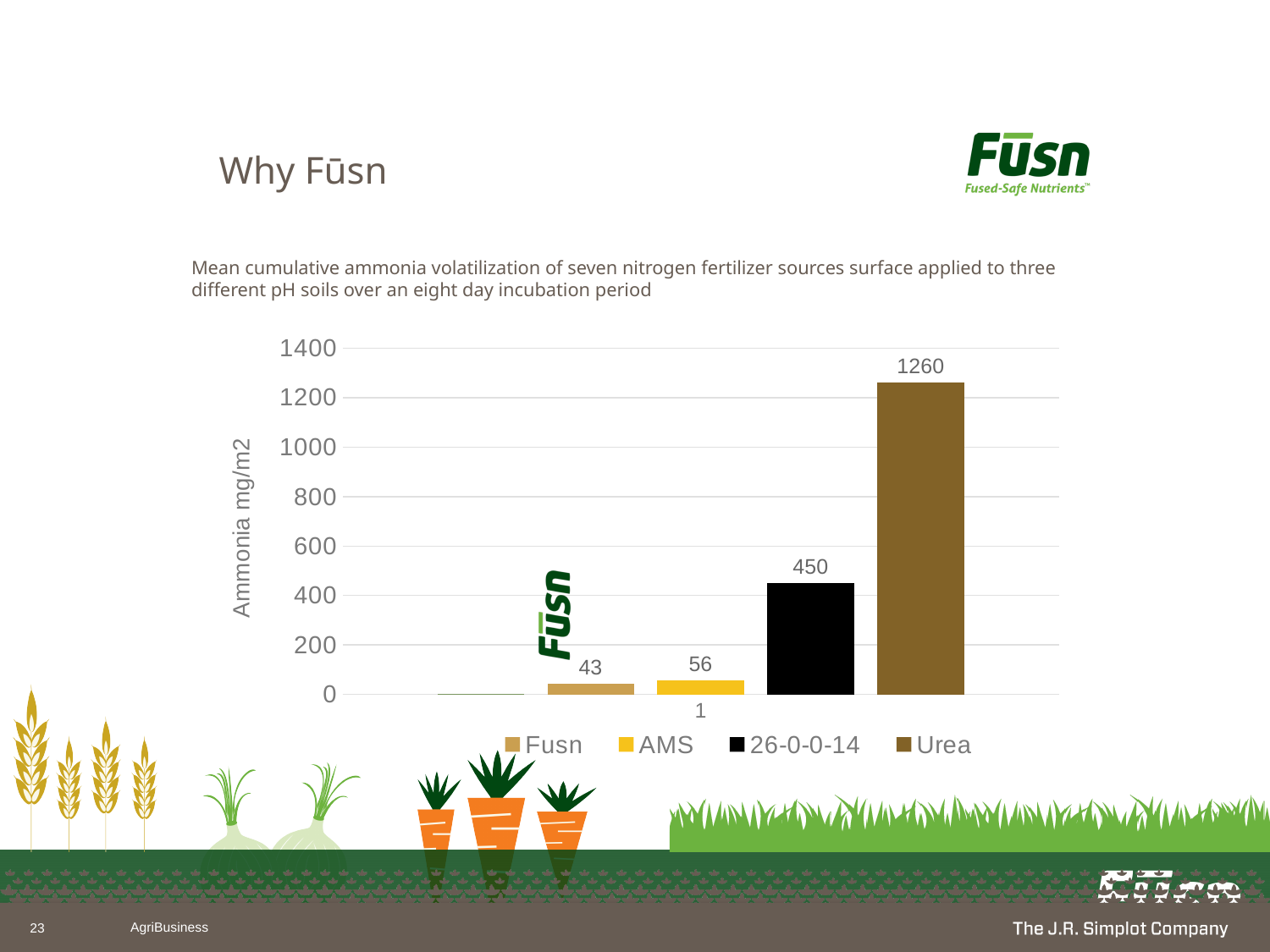
What is the y-axis title of the chart? Ammonia mg/m2 What is the difference between the Urea value and the 26-0-0-14 value? 810 What is the value for 26-0-0-14? 450 Is the value for Urea greater or less than 1200? greater What is the value for Fusn? 43 What is the value for Urea? 1260 Which labelled series has the highest value? Urea Which labelled series has the lowest value? Fusn How many series does the legend list? 4 What is the difference between the AMS value and the Fusn value? 13 Which is larger, the value for 26-0-0-14 or the value for AMS? 26-0-0-14 What is the value for AMS? 56